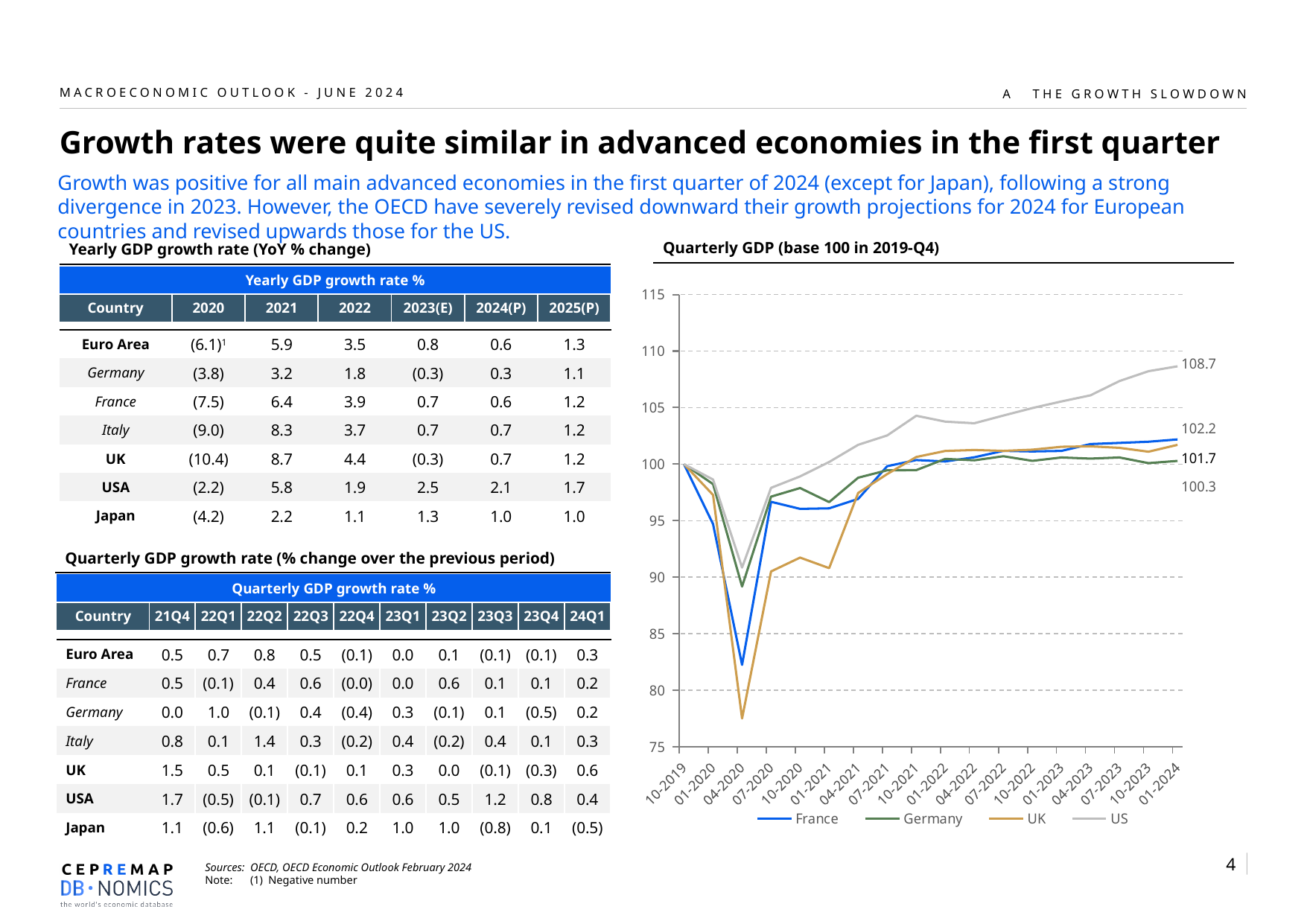
In the Quarterly GDP chart, which colour is used for the US line? grey In the Quarterly GDP chart, what is the value labelled for the US at the end of the series (01-2024)? 108.7 In the Quarterly GDP chart, what is the value labelled for France at 01-2024? 102.2 How many series does the legend of the Quarterly GDP chart list? 4 In the Quarterly GDP chart, what is the difference between the US and France values at 01-2024? 6.5 In the Quarterly GDP chart, is the value for Germany in 04-2020 greater or less than 85? greater In the Quarterly GDP chart, which country has the lowest value at 01-2024? Germany In the Quarterly GDP chart, is the value for the UK in 04-2020 greater or less than 80? less What kind of chart is the 'Quarterly GDP (base 100 in 2019-Q4)' chart? line chart In the Quarterly GDP chart, what is the value labelled for the UK at 01-2024? 101.7 In the Quarterly GDP chart, which country has the highest value at 01-2024? US In the Quarterly GDP chart, what is the value labelled for Germany at 01-2024? 100.3